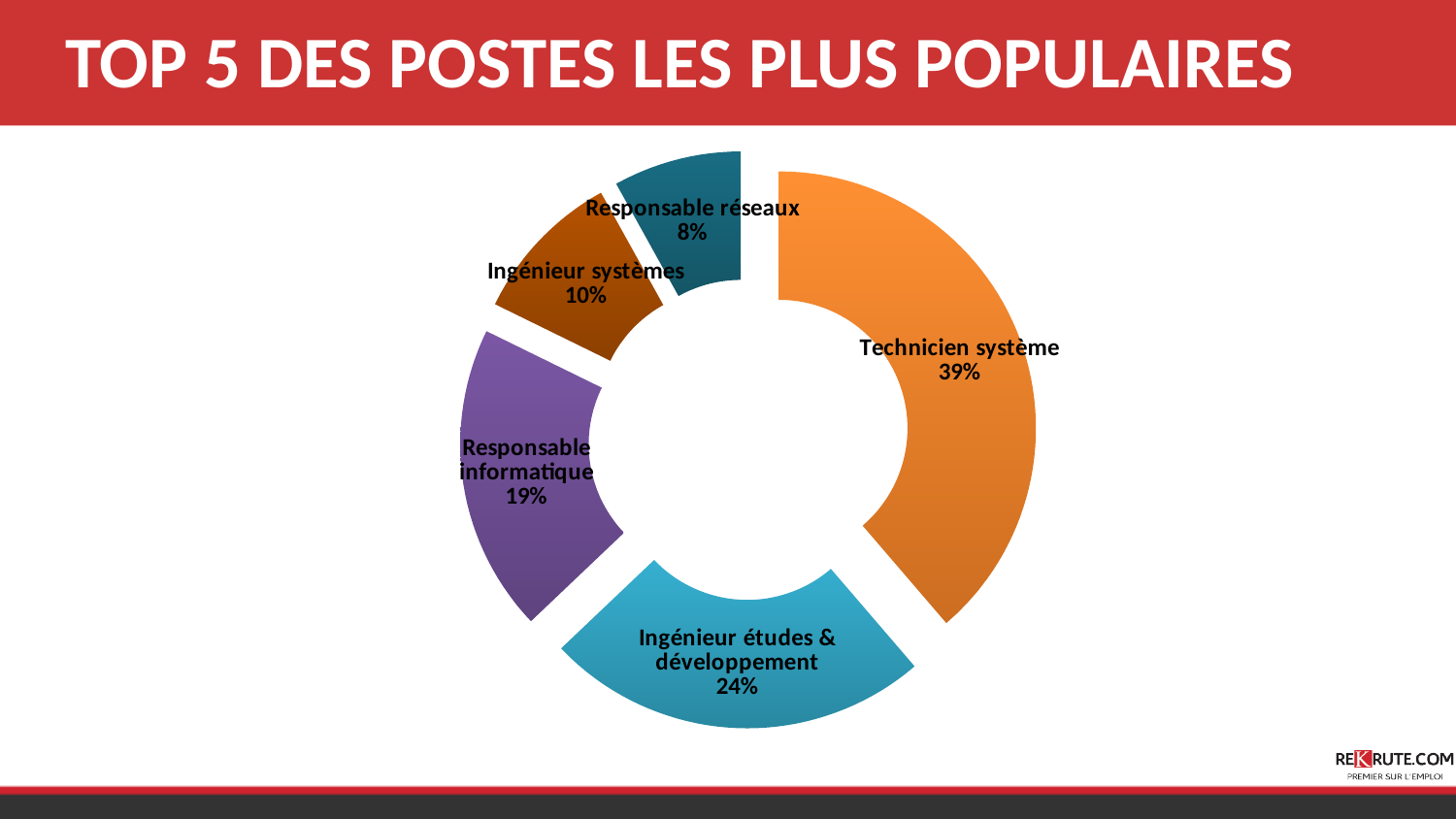
How many categories are shown in the chart? 5 What kind of chart is shown on the slide? Doughnut (pie) chart What is the difference between the shares of Technicien système and Ingénieur études & développement? 15% Which is larger, the share for Responsable informatique or the share for Ingénieur systèmes? Responsable informatique What is the value shown for Ingénieur études & développement? 24% Which category has the smallest share of the chart? Responsable réseaux What is the value for Ingénieur systèmes? 10% Which category has the largest share of the chart? Technicien système What is the title of the slide? TOP 5 DES POSTES LES PLUS POPULAIRES What percentage is shown for Responsable informatique? 19% What is the value for Responsable réseaux? 8% What share does Technicien système have in the chart? 39%